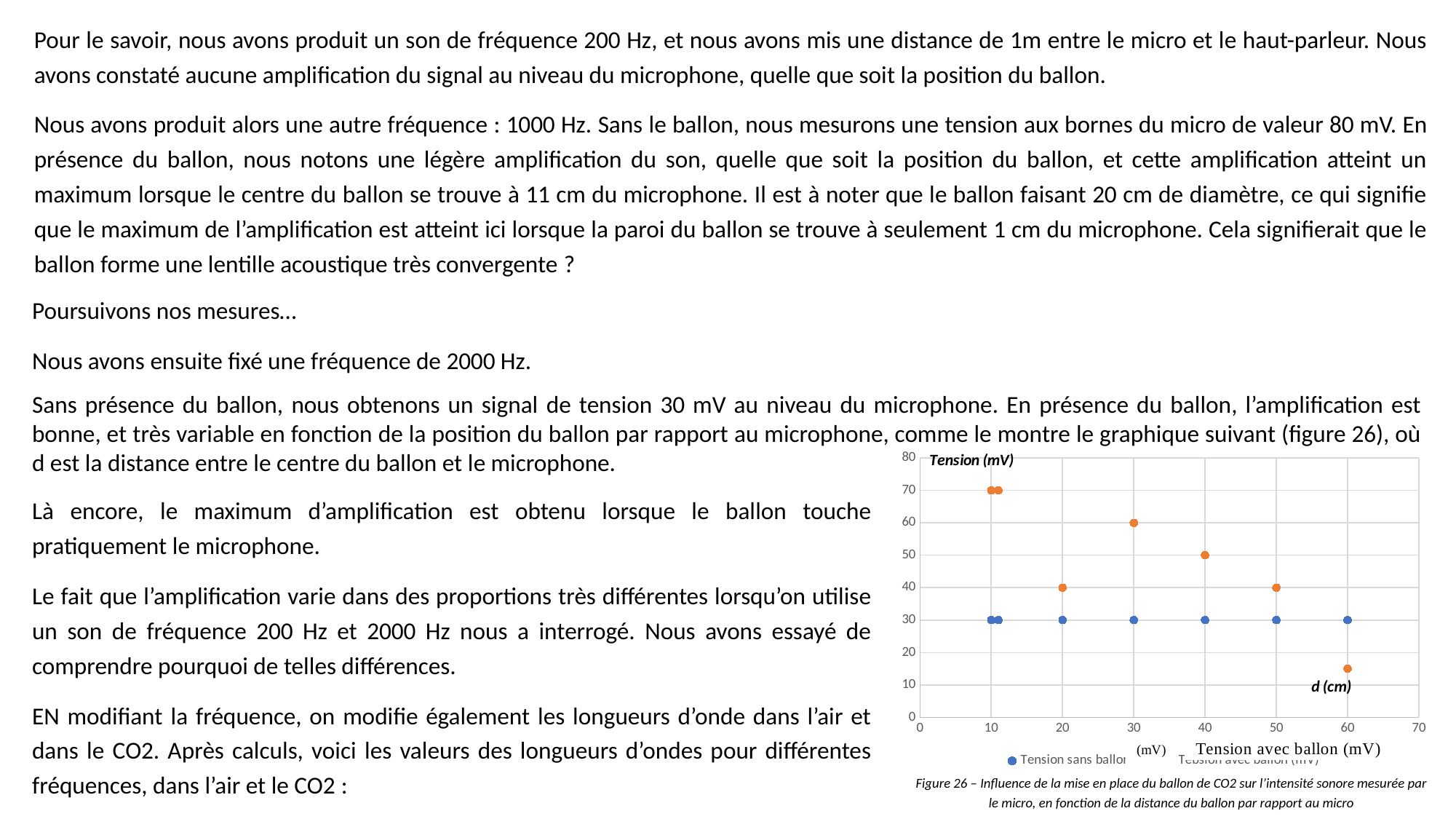
Is the value of 'Tension avec ballon' at d = 60 cm greater or less than 20? less What is the label of the horizontal axis of the chart? d (cm) At which distance d is 'Tension avec ballon' lowest? 60 What kind of chart is shown in Figure 26? scatter chart What is the value of 'Tension avec ballon' at d = 40 cm? 50 What is the value of 'Tension sans ballon' at d = 40 cm? 30 Which series has the larger value at d = 50 cm, 'Tension sans ballon' or 'Tension avec ballon'? Tension avec ballon Does 'Tension avec ballon' rise or fall as d increases from 30 cm to 60 cm? fall What is the label of the vertical axis of the chart? Tension (mV) What is the value of 'Tension avec ballon' at d = 30 cm? 60 What is the value of 'Tension avec ballon' at d = 20 cm? 40 How many series does the legend of the chart list? 2